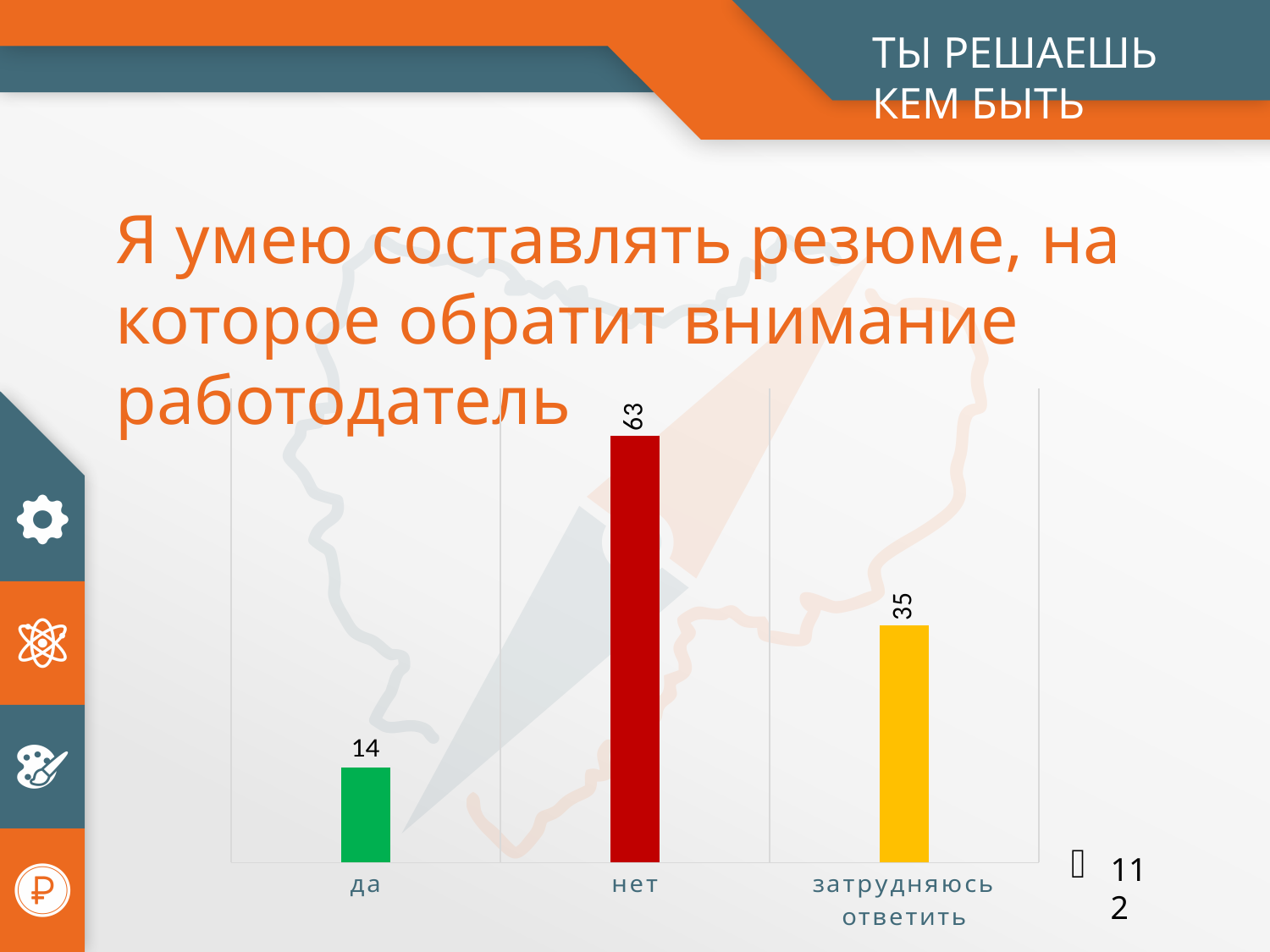
What is the value for "нет"? 63 What is the value for "затрудняюсь ответить"? 35 How many categories are shown in the chart? 3 What colour is the bar for "нет"? red What kind of chart is shown on the slide? bar chart What is the value for "да"? 14 Which category has the lowest value? да Which is larger, the value for "затрудняюсь ответить" or the value for "да"? затрудняюсь ответить What is the total of the three values shown in the chart? 112 What is the difference between the values for "нет" and "да"? 49 Which category has the highest value? нет What is the difference between the values for "нет" and "затрудняюсь ответить"? 28